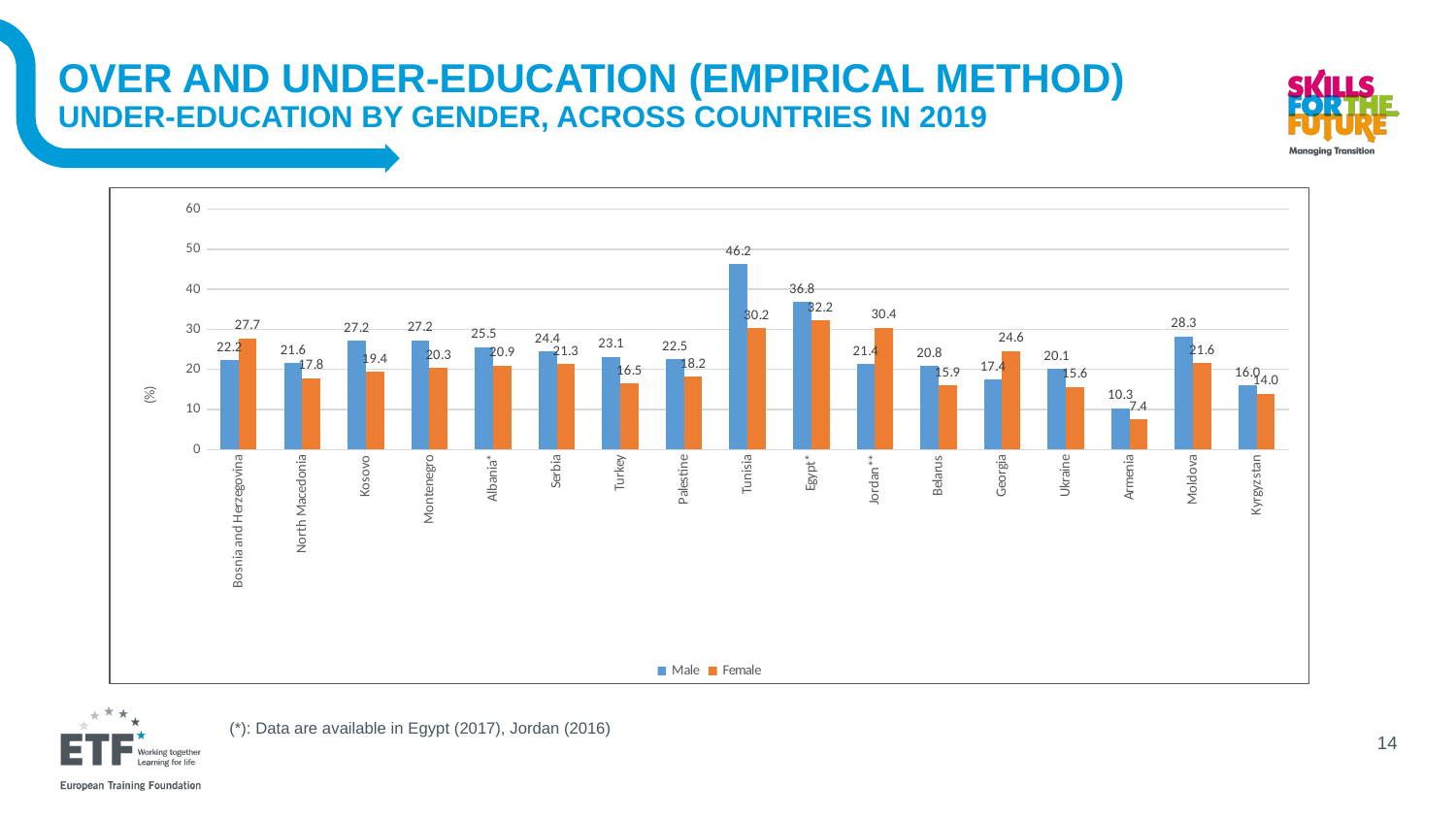
How many countries are shown on the x axis? 17 What is the Female value for Georgia? 24.6 What is the Male value for Moldova? 28.3 Which country has the lowest Female value? Armenia What is the Male value for Tunisia? 46.2 Which country has the highest Male value? Tunisia What is the difference between the Male and Female values for Jordan**? 9.0 For Bosnia and Herzegovina, which is larger, the Male or the Female value? Female What are the two entries in the chart legend? Male and Female What is the difference between the Male and Female values for Tunisia? 16.0 How many series does the legend list? 2 What kind of chart is shown on the slide? Bar chart